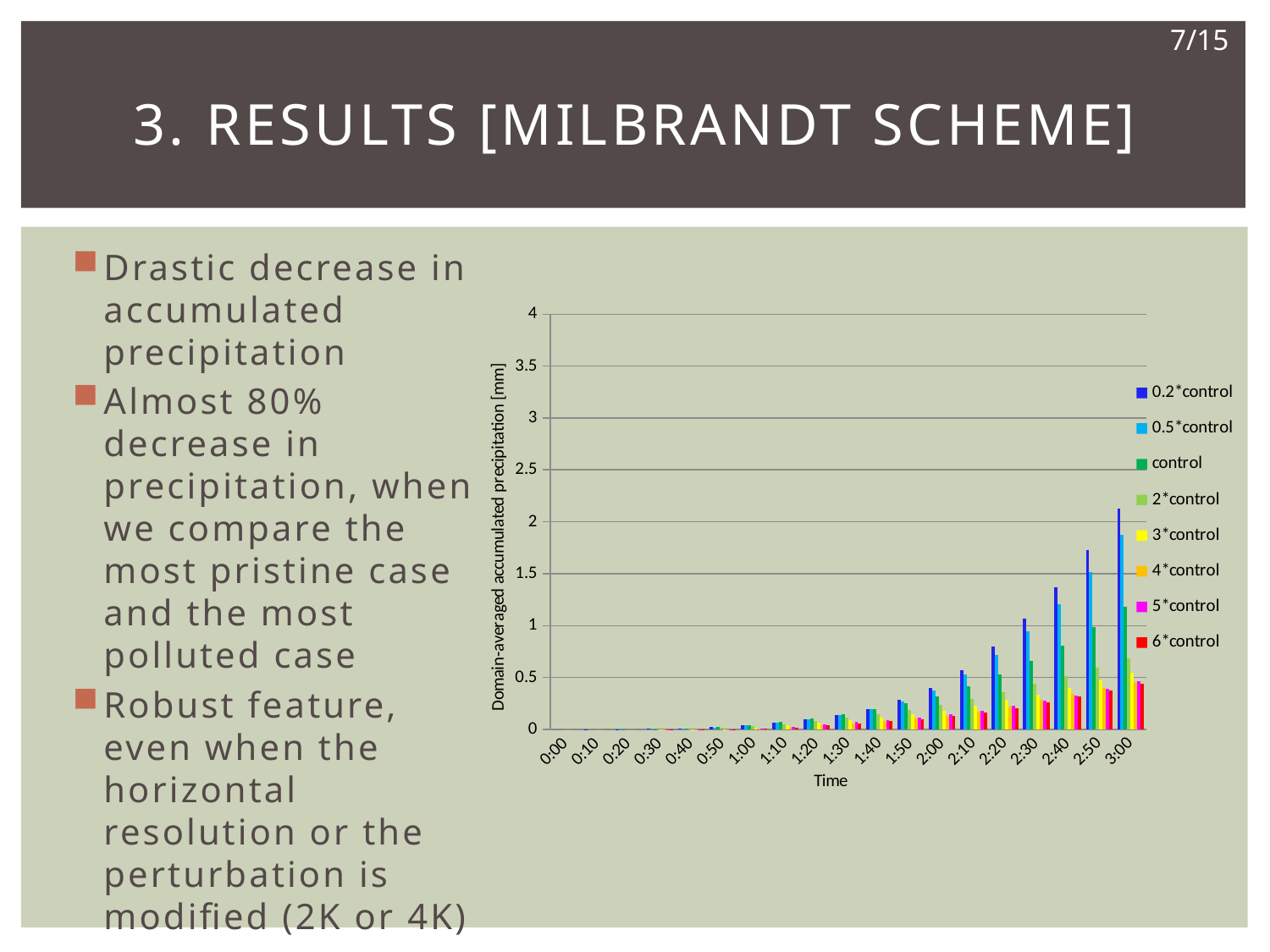
What kind of chart is shown on the slide? bar chart Which series has the highest value at 3:00? 0.2*control Is the value for 0.5*control at 3:00 greater or less than 1.5? greater Is the value for 0.2*control at 2:40 greater or less than 1? greater What is the label on the y axis of the chart? Domain-averaged accumulated precipitation [mm] At 3:00, which is larger: the value for 0.2*control or the value for control? 0.2*control Do the values for 0.2*control rise or fall as time increases along the x axis? rise Is the value for 6*control at 3:00 greater or less than 0.5? less What is the label on the x axis of the chart? Time How many time points are shown along the x axis of the chart? 19 How many series does the chart legend list? 8